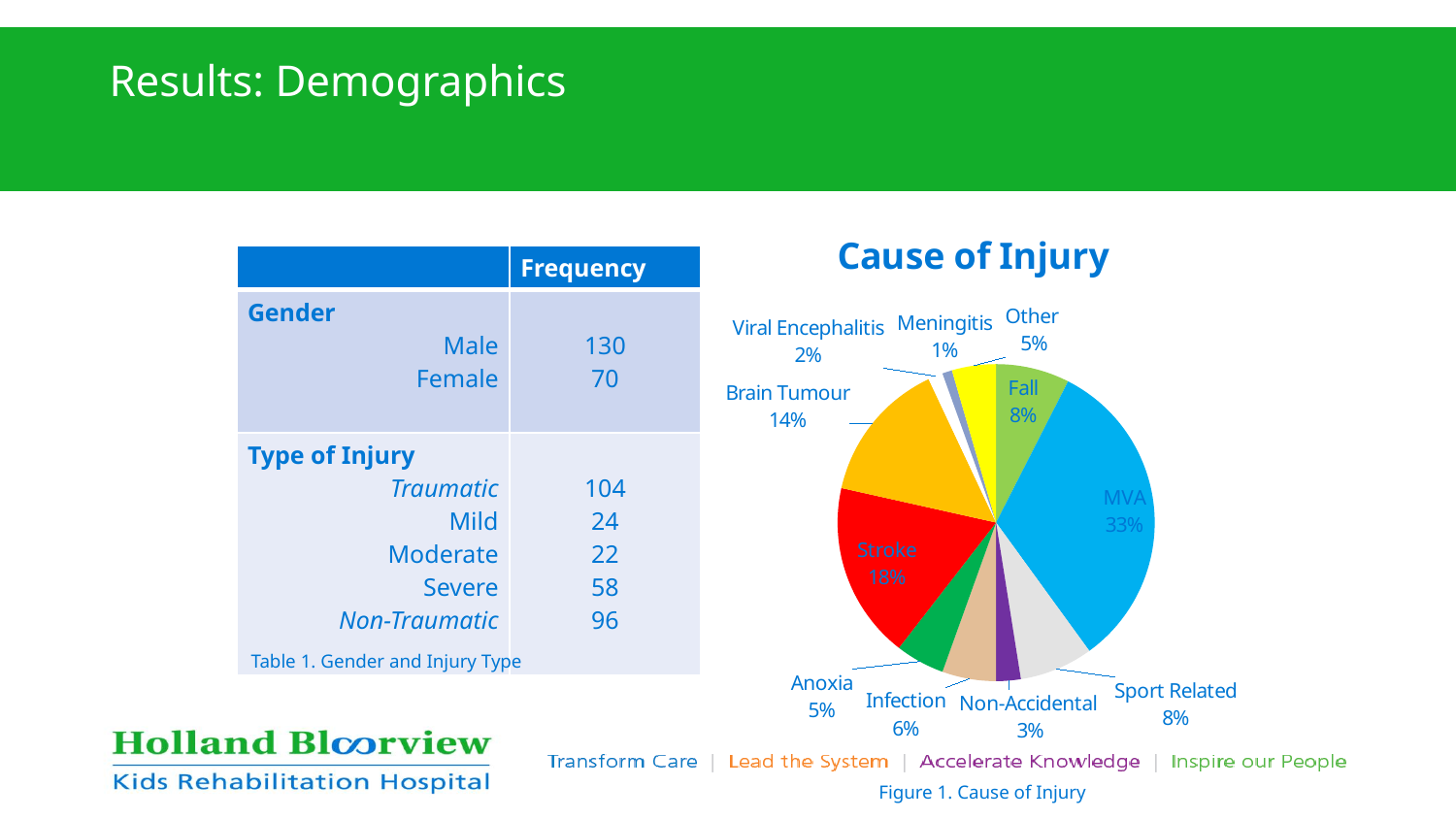
What share of the pie does MVA account for? 33% What percentage is shown for Meningitis? 1% What is the title of the chart on the slide? Cause of Injury What is the difference in percentage points between Brain Tumour and Fall? 6 How many slices does the Cause of Injury pie chart have? 11 What percentage is shown for Brain Tumour? 14% Which cause of injury has the largest slice of the pie? MVA What kind of chart is shown under the title "Cause of Injury"? pie chart Which cause of injury has the smallest slice of the pie? Meningitis Which is larger, the share for Infection or the share for Anoxia? Infection What is the difference in percentage points between MVA and Stroke? 15 What percentage is shown for Stroke in the Cause of Injury pie chart? 18%